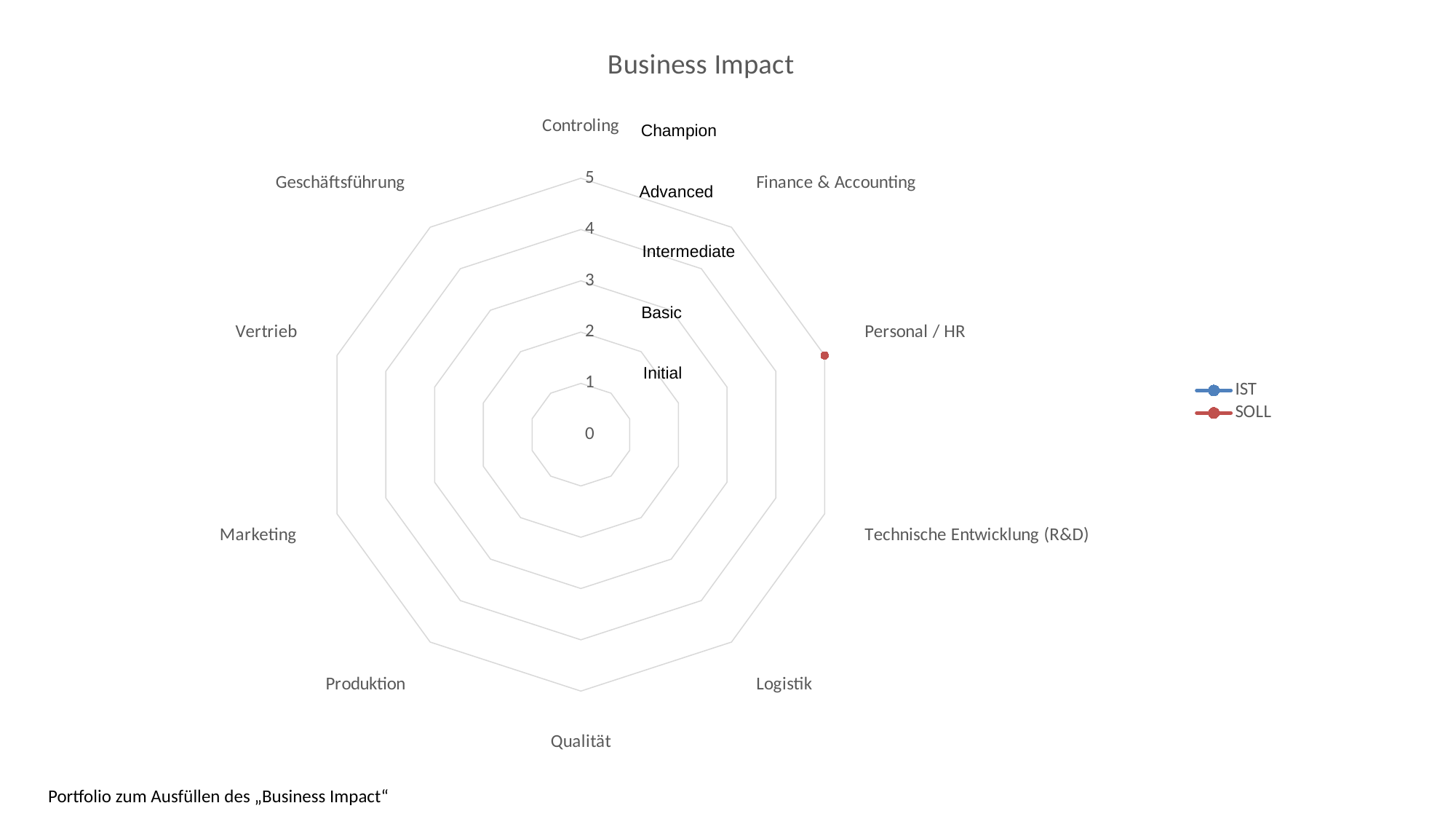
What is the title of the chart? Business Impact For which category is a SOLL data point plotted? Personal / HR How many series does the legend list? 2 What is the maximum value shown on the chart's scale? 5 How many categories (axes) does the radar chart have? 10 What kind of chart is shown on the slide? radar chart Is the SOLL value for Personal / HR greater or less than 3? greater Which series is shown in red in the legend? SOLL What is the SOLL value for Personal / HR? 5